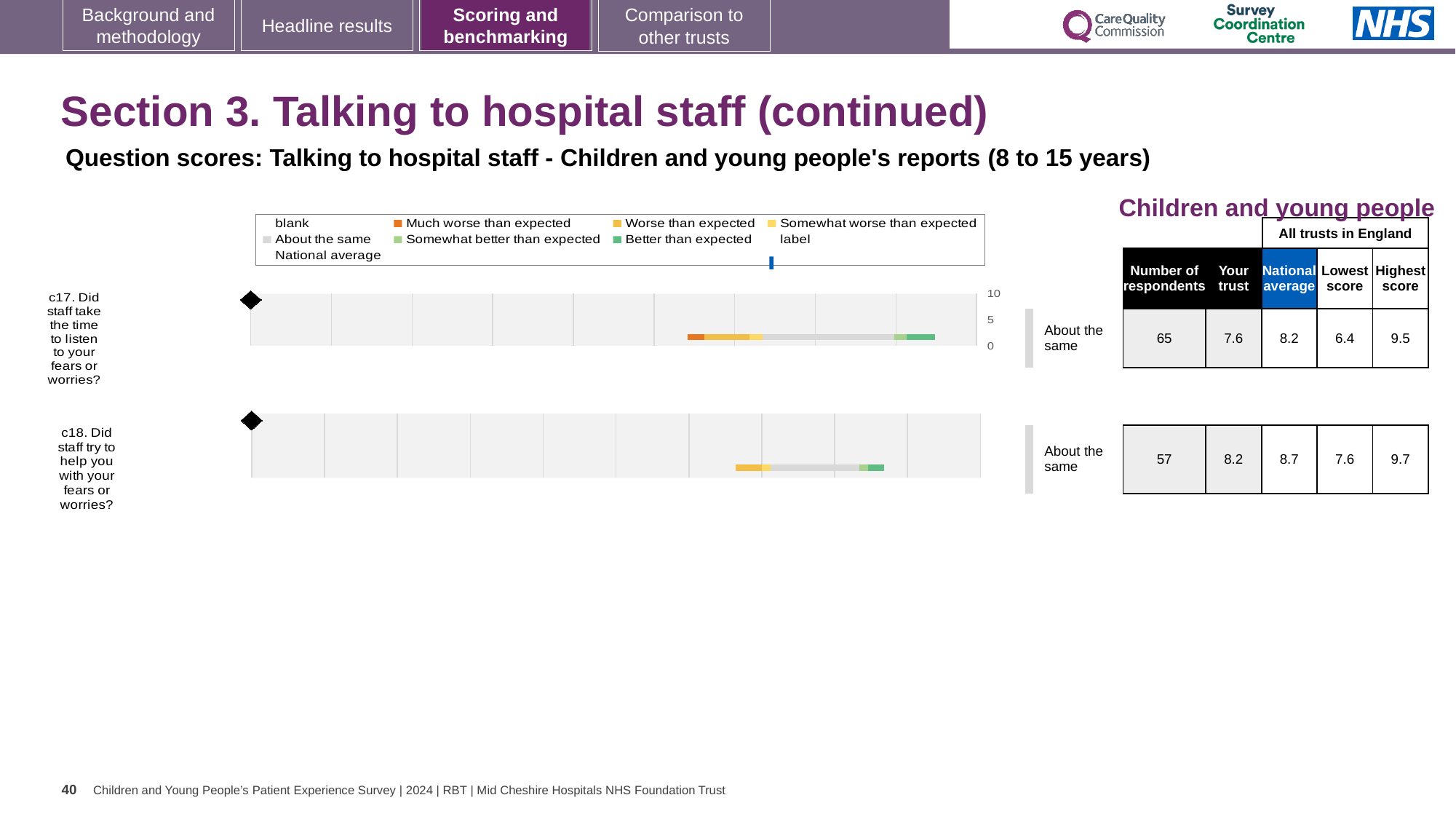
By how much does the national average exceed the trust's score for question c17? 0.6 What is the 'Your trust' score for question c17 (Did staff take the time to listen to your fears or worries?)? 7.6 How many respondents answered question c18 (Did staff try to help you with your fears or worries?)? 57 How many survey questions are charted on this slide? 2 What is the 'Your trust' score for question c18? 8.2 What is the difference between the highest and lowest scores for question c18? 2.1 What benchmark rating is shown for question c17? About the same What is the highest score among all trusts in England for question c17? 9.5 What is the lowest score among all trusts in England for question c17? 6.4 What is the national average score for question c17? 8.2 What is the national average score for question c18? 8.7 Which question has the higher 'Your trust' score, c17 or c18? c18